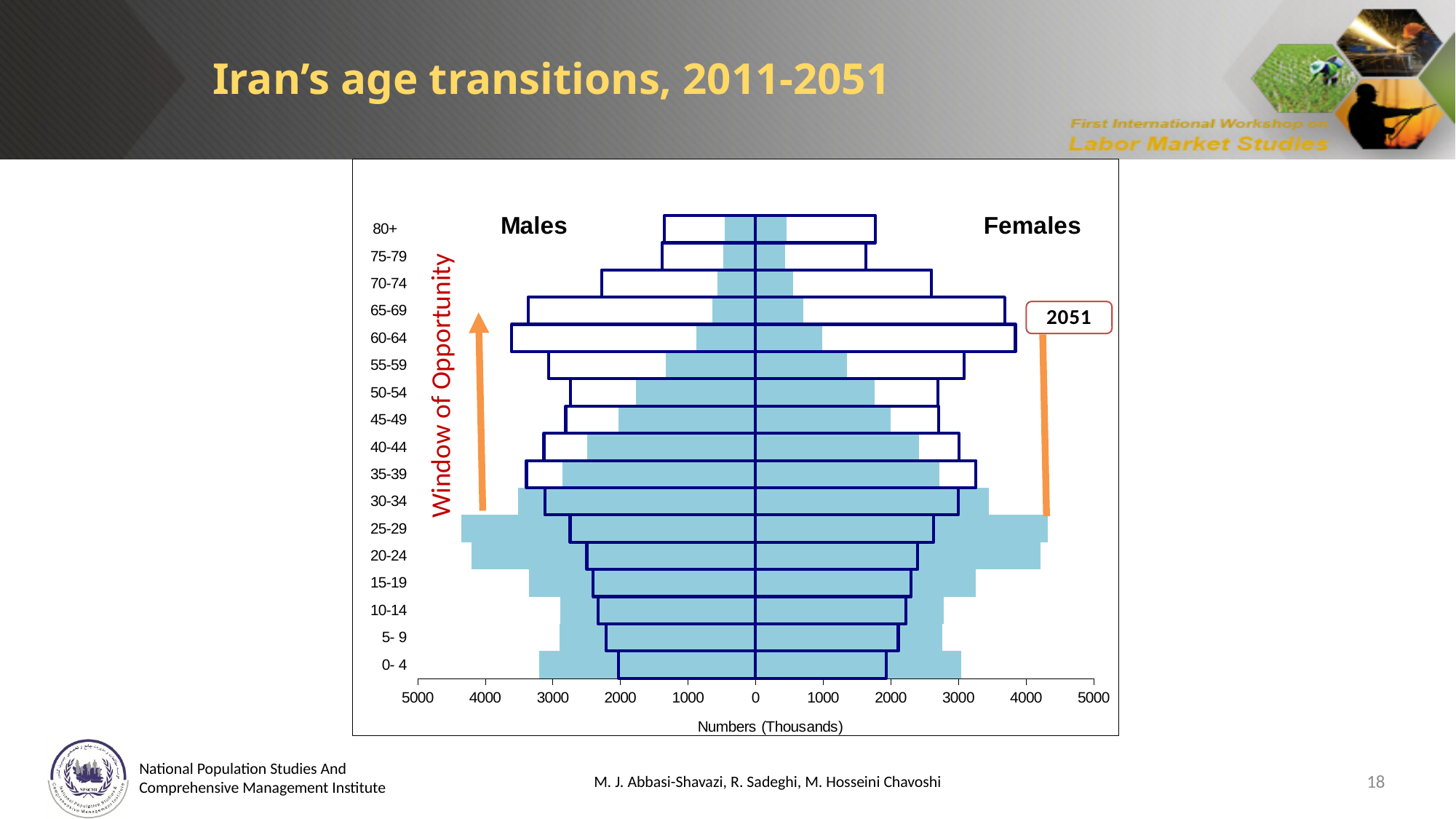
Which age group has the largest outlined (2051) bar for females? 60-64 Is the shaded (filled) value for males aged 25-29 greater or less than 4000? greater Is the shaded (filled) value for females aged 0-4 greater or less than 4000? less Which age group has the largest shaded (filled) bar for males? 25-29 Which year is labelled on the right side of the chart next to the outlined bars? 2051 Which age group has the smallest outlined (2051) bar for males? 80+ Is the outlined (2051) value for males aged 60-64 greater or less than 3000? greater What kind of chart is shown on the slide? Bar chart (population pyramid) How many age groups are listed on the vertical axis of the pyramid? 17 What is the title of the horizontal axis of the chart? Numbers (Thousands) For the outlined (2051) bars, which is larger for females: the 60-64 age group or the 0-4 age group? 60-64